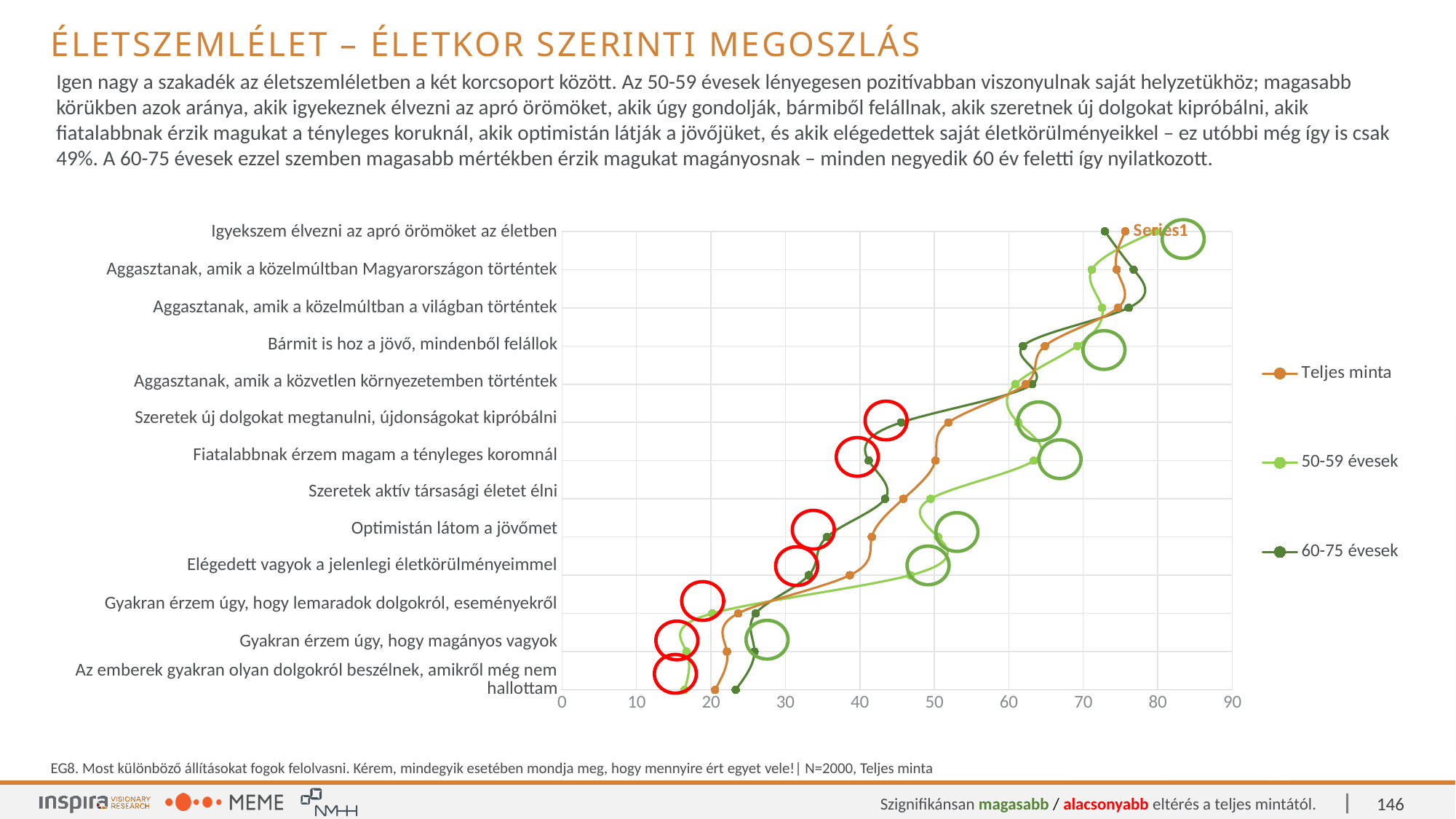
Do the Teljes minta values increase or decrease going from the top statement to the bottom statement? decrease Is the 50-59 évesek value for 'Gyakran érzem úgy, hogy magányos vagyok' greater or less than 20? less For 'Gyakran érzem úgy, hogy magányos vagyok', which series has the larger value: 50-59 évesek or 60-75 évesek? 60-75 évesek What kind of chart is shown on the slide? line chart Which statement has the highest value for the Teljes minta series? Igyekszem élvezni az apró örömöket az életben For 'Fiatalabbnak érzem magam a tényleges koromnál', which series has the larger value: 50-59 évesek or 60-75 évesek? 50-59 évesek How many statements (categories) are plotted on the vertical axis of the chart? 13 Which series are listed in the chart legend? Teljes minta, 50-59 évesek, 60-75 évesek How many series does the chart legend list? 3 What is the highest value shown on the horizontal axis of the chart? 90